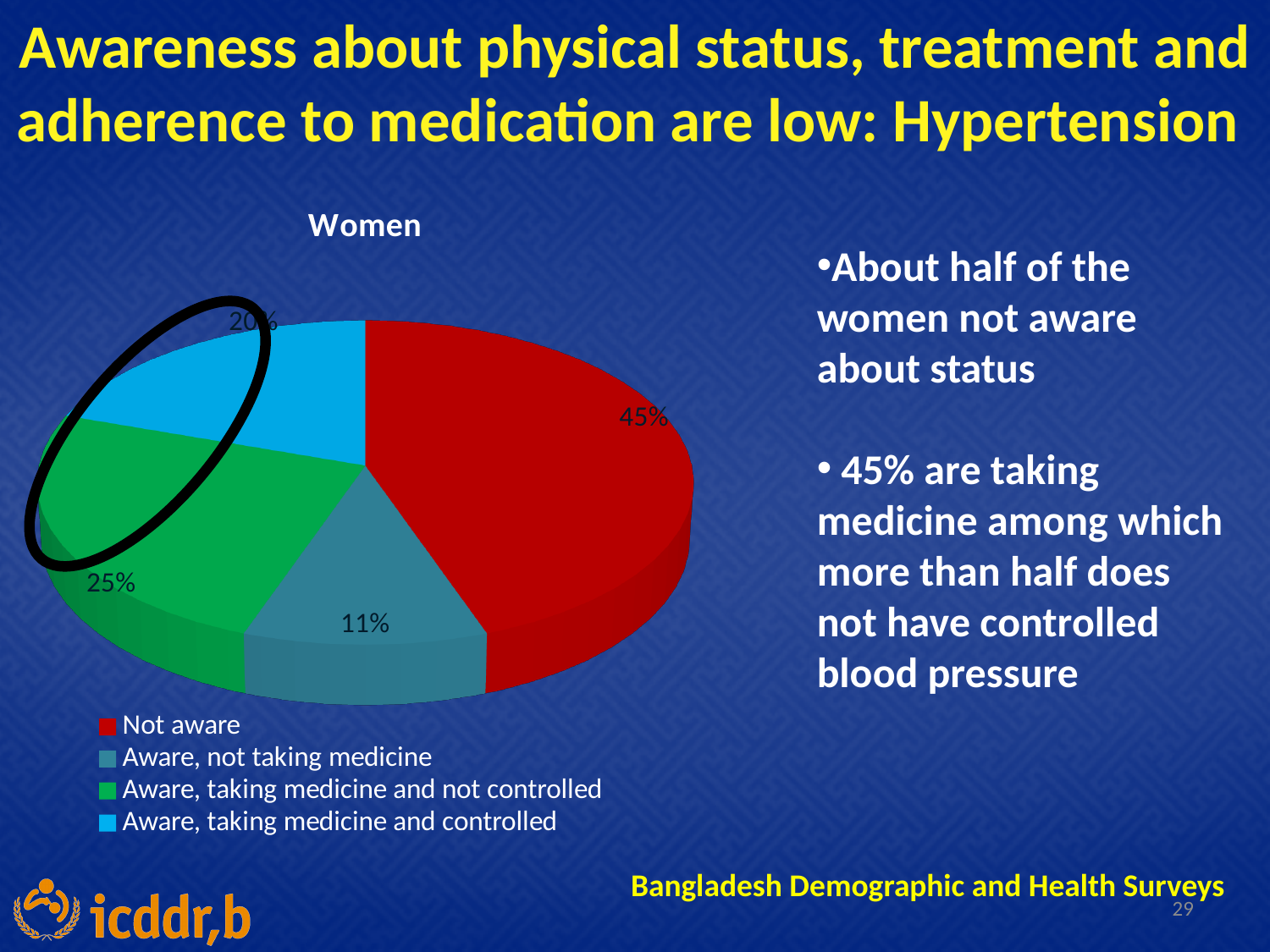
What is the title of the pie chart? Women Which is larger: 'Aware, taking medicine and not controlled' or 'Aware, not taking medicine'? Aware, taking medicine and not controlled What percentage of women are 'Aware, taking medicine and not controlled'? 25% What colour represents the 'Not aware' category in the pie chart? Red What is the difference in percentage points between 'Not aware' and 'Aware, not taking medicine'? 34 percentage points What percentage of women are 'Aware, not taking medicine'? 11% What kind of chart is shown on the slide? Pie chart Which category has the smallest share of the pie? Aware, not taking medicine What percentage of women are in the 'Not aware' category? 45% How many categories does the pie chart have? 4 What is the difference in percentage points between 'Aware, taking medicine and not controlled' and 'Aware, not taking medicine'? 14 percentage points Which category has the largest share of the pie? Not aware